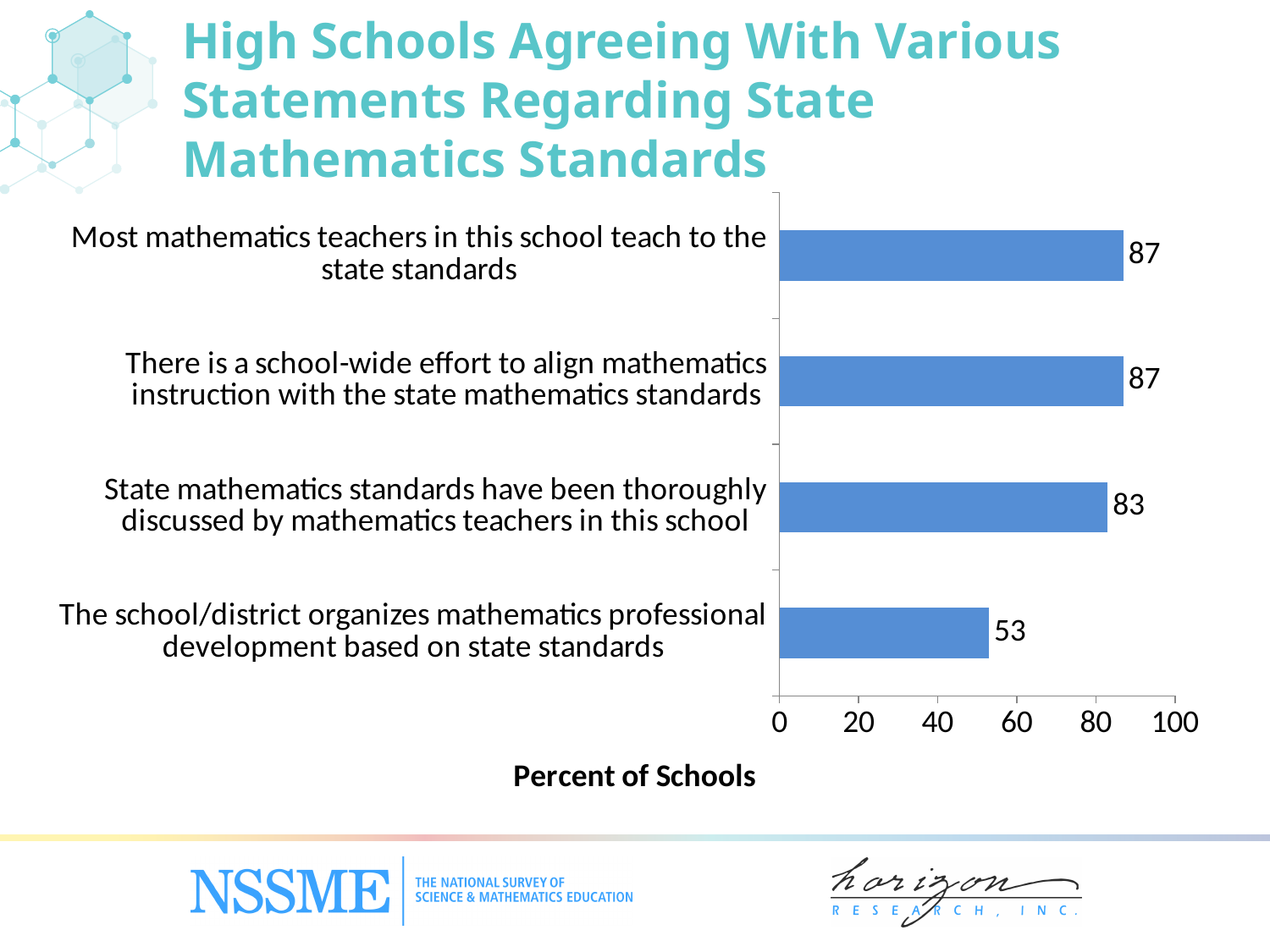
How many statements are shown in the chart? 4 What kind of chart is shown on the slide? bar chart What is the difference between the percent of schools agreeing that state mathematics standards have been thoroughly discussed and the percent agreeing that the school/district organizes professional development based on state standards? 30 Which is larger: the percent of schools agreeing there is a school-wide effort to align instruction with state standards, or the percent agreeing the school/district organizes professional development based on state standards? There is a school-wide effort to align mathematics instruction with the state mathematics standards What percent of schools agree that state mathematics standards have been thoroughly discussed by mathematics teachers in this school? 83 What is the difference between the percent of schools agreeing that most mathematics teachers teach to the state standards and the percent agreeing that state standards have been thoroughly discussed? 4 What is the maximum value shown on the horizontal axis? 100 Which statement has the lowest percent of schools agreeing? The school/district organizes mathematics professional development based on state standards What percent of schools agree that the school/district organizes mathematics professional development based on state standards? 53 Is the value for the statement about the school/district organizing professional development greater or less than 60? less What percent of schools agree that most mathematics teachers in this school teach to the state standards? 87 What is the label on the horizontal axis of the chart? Percent of Schools